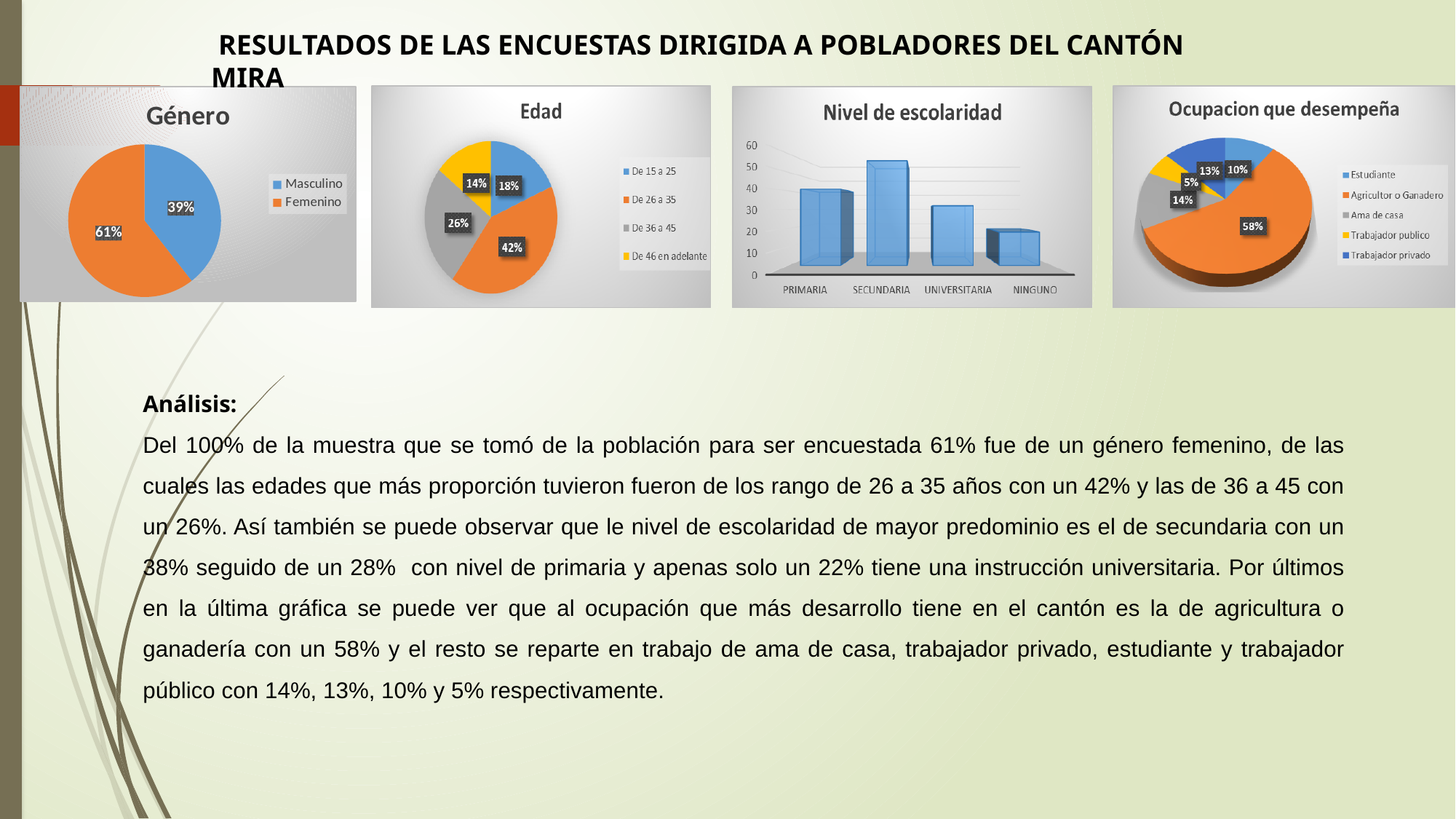
What kind of chart is the Nivel de escolaridad chart? Bar chart In the Edad chart, what is the difference between the De 36 a 45 slice and the De 15 a 25 slice? 8% In the Edad chart, which age range has the smallest share? De 46 en adelante In the Género chart, what percentage is Masculino? 39% In the Nivel de escolaridad chart, which category has the highest bar? SECUNDARIA In the Nivel de escolaridad chart, is the value for UNIVERSITARIA greater or less than 40? less In the Edad chart, what percentage is the De 26 a 35 slice? 42% In the Ocupacion que desempeña chart, which is larger, Ama de casa or Trabajador privado? Ama de casa In the Edad chart, how many categories does the legend list? 4 In the Nivel de escolaridad chart, which category has the lowest bar? NINGUNO In the Ocupacion que desempeña chart, what percentage is Agricultor o Ganadero? 58% In the Género chart, what percentage is Femenino? 61%